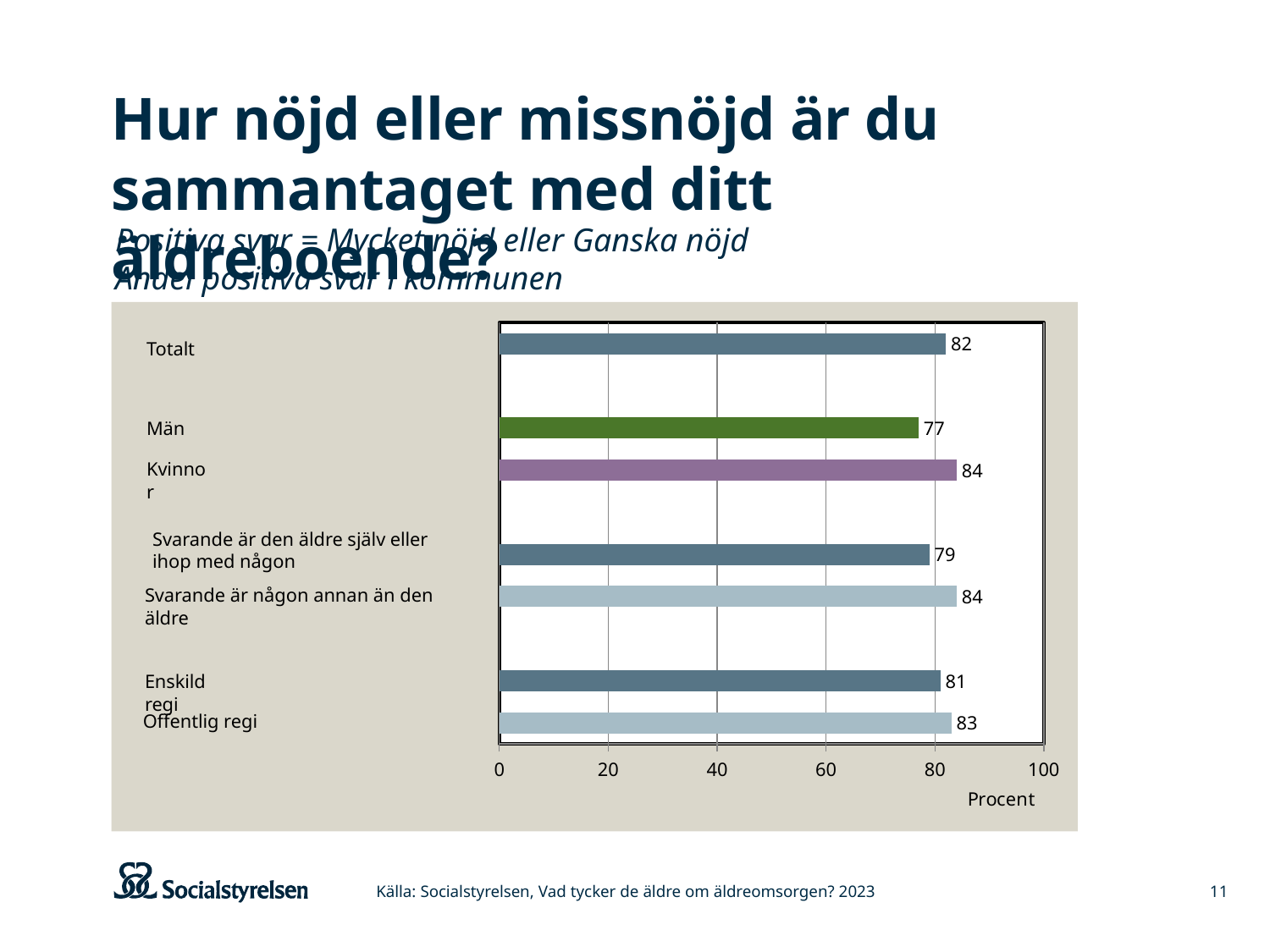
What is the value for Män? 77 How many categories (bars) are shown in the chart? 7 What kind of chart is shown on the slide? Bar chart What is the value for Kvinnor? 84 What is the difference between the values for Kvinnor and Män? 7 What is the value for Enskild regi? 81 What is the label on the horizontal axis of the chart? Procent What is the value for 'Svarande är den äldre själv eller ihop med någon'? 79 Which is larger, the value for Offentlig regi or the value for Enskild regi? Offentlig regi Which category has the lowest value? Män What is the value for Totalt? 82 What is the value for Offentlig regi? 83